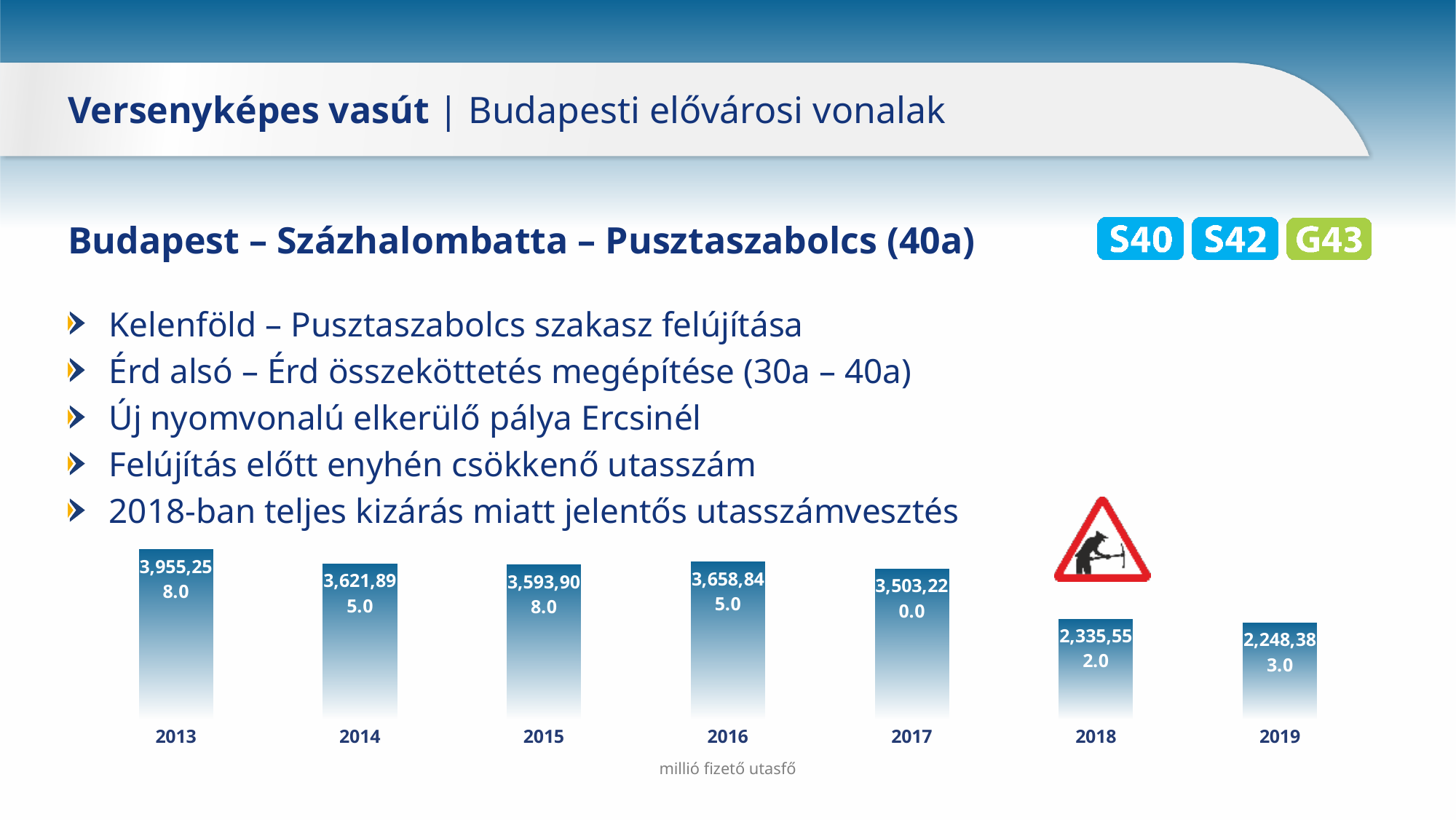
Which year has the highest value? 2013 Which year has the lowest value? 2019 What is the difference between the values for 2017 and 2018? 1,167,668.0 What is the value for 2019? 2,248,383.0 What kind of chart is shown on the slide? Bar chart What is the value for 2017? 3,503,220.0 What unit label is printed below the chart? millió fizető utasfő What is the difference between the values for 2013 and 2014? 333,363.0 Which is larger, the value for 2015 or the value for 2016? 2016 What is the value for 2018? 2,335,552.0 How many years are shown in the chart? 7 What is the value for 2013? 3,955,258.0